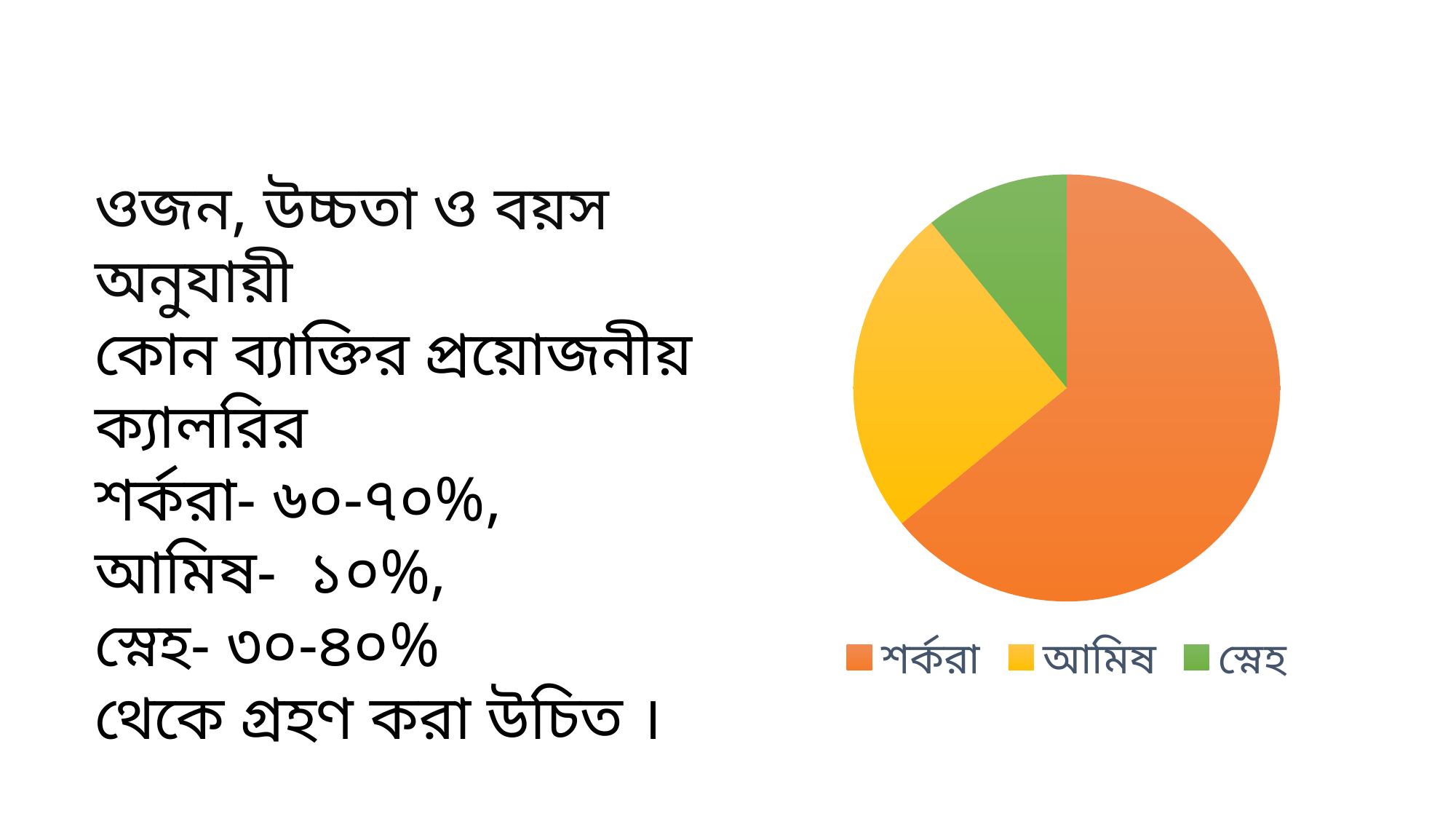
How many entries does the legend of the pie chart list? 3 Which slice is larger in the pie chart, শর্করা or আমিষ? শর্করা What kind of chart is shown on the slide? pie chart Which category has the largest slice in the pie chart? শর্করা Which category has the smallest slice in the pie chart? স্নেহ Which category is shown in green in the pie chart? স্নেহ What colour is the শর্করা slice in the pie chart? orange How many slices does the pie chart have? 3 Which slice is larger in the pie chart, আমিষ or স্নেহ? আমিষ Does the শর্করা slice take up more or less than half of the pie chart? more